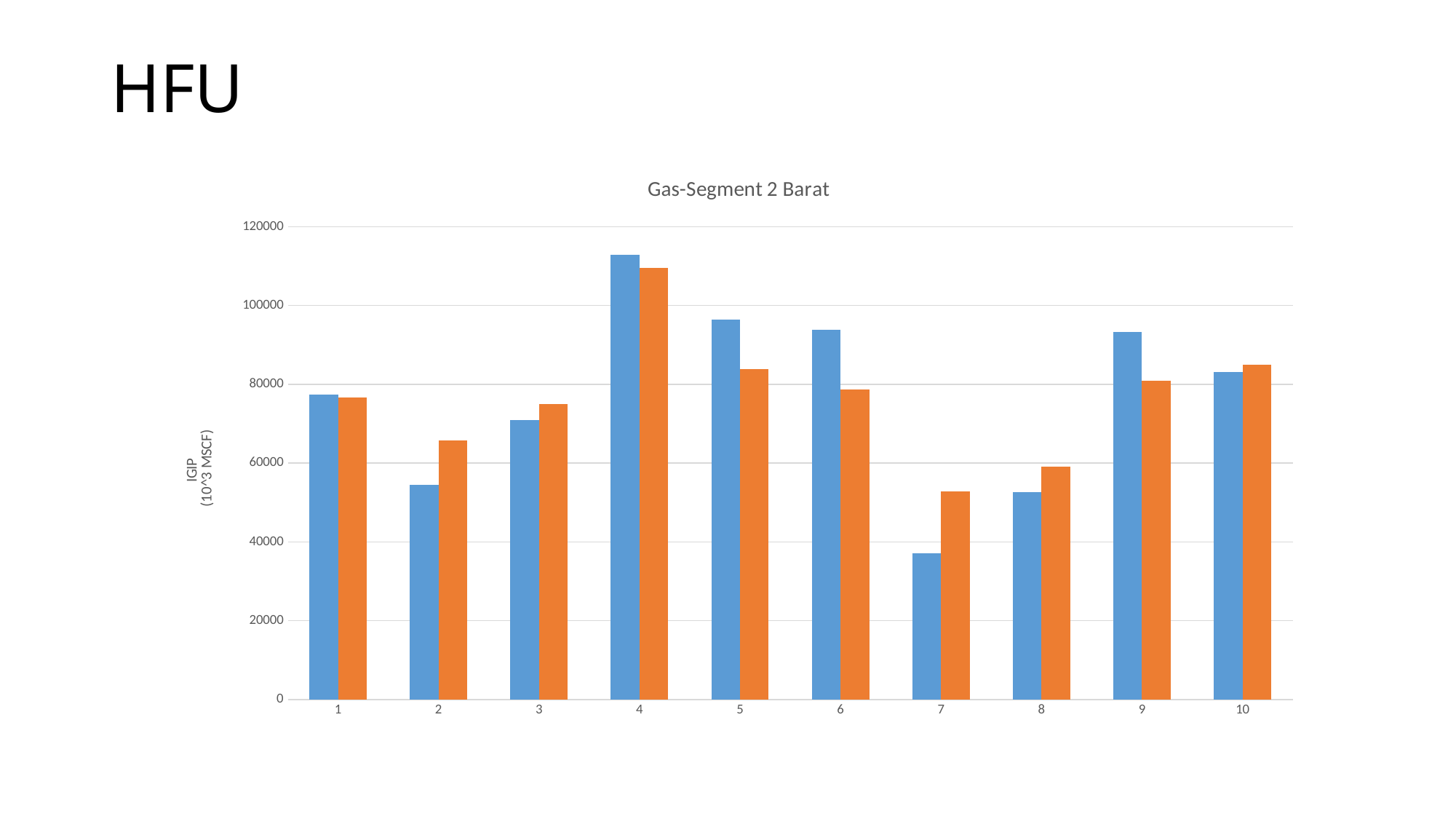
What kind of chart is shown on the slide? bar chart Is the blue bar for category 7 greater or less than 40000? less Is the blue bar for category 4 greater or less than 100000? greater How many categories are shown along the x axis of the chart? 10 What is the title of the chart? Gas-Segment 2 Barat What is the label on the vertical axis of the chart? IGIP (10^3 MSCF) For category 2, which bar is taller, the blue one or the orange one? orange For which category is the blue bar the highest? 4 For category 5, which bar is taller, the blue one or the orange one? blue For which category is the orange bar the highest? 4 For which category is the orange bar the lowest? 7 For which category is the blue bar the lowest? 7